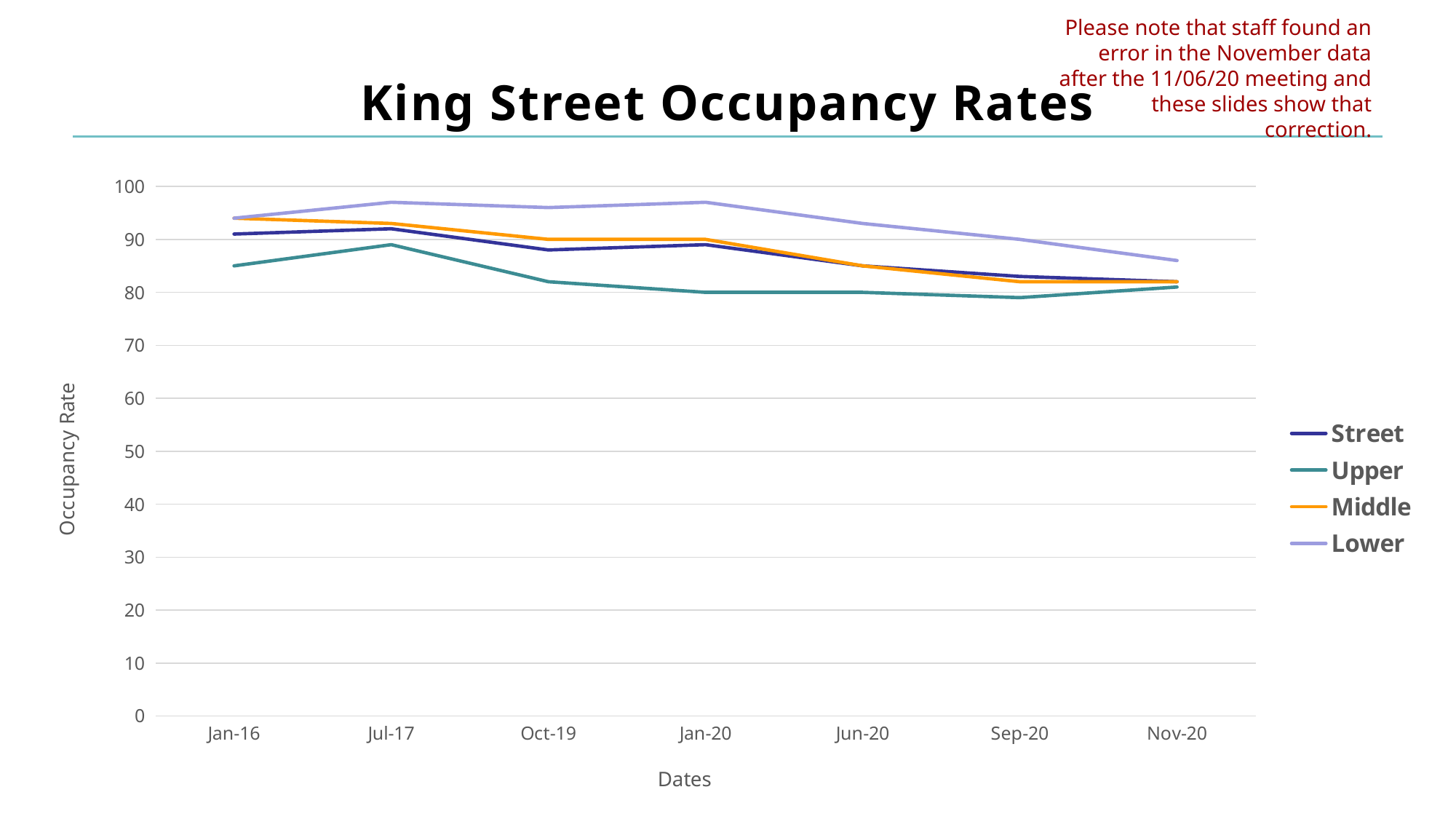
At Jul-17, which series has the larger value, Lower or Upper? Lower Does the Lower series rise or fall from Jan-20 to Nov-20? fall What type of chart is shown on the slide? line chart How many series does the legend list? 4 Which series has the highest occupancy rate at Nov-20? Lower How many dates are shown along the x axis? 7 Is the value for Lower at Nov-20 greater or less than 90? less What is the label on the y axis? Occupancy Rate What is the title of the chart? King Street Occupancy Rates Which series has the lowest occupancy rate at Jan-16? Upper Is the value for Lower at Jul-17 greater or less than 90? greater